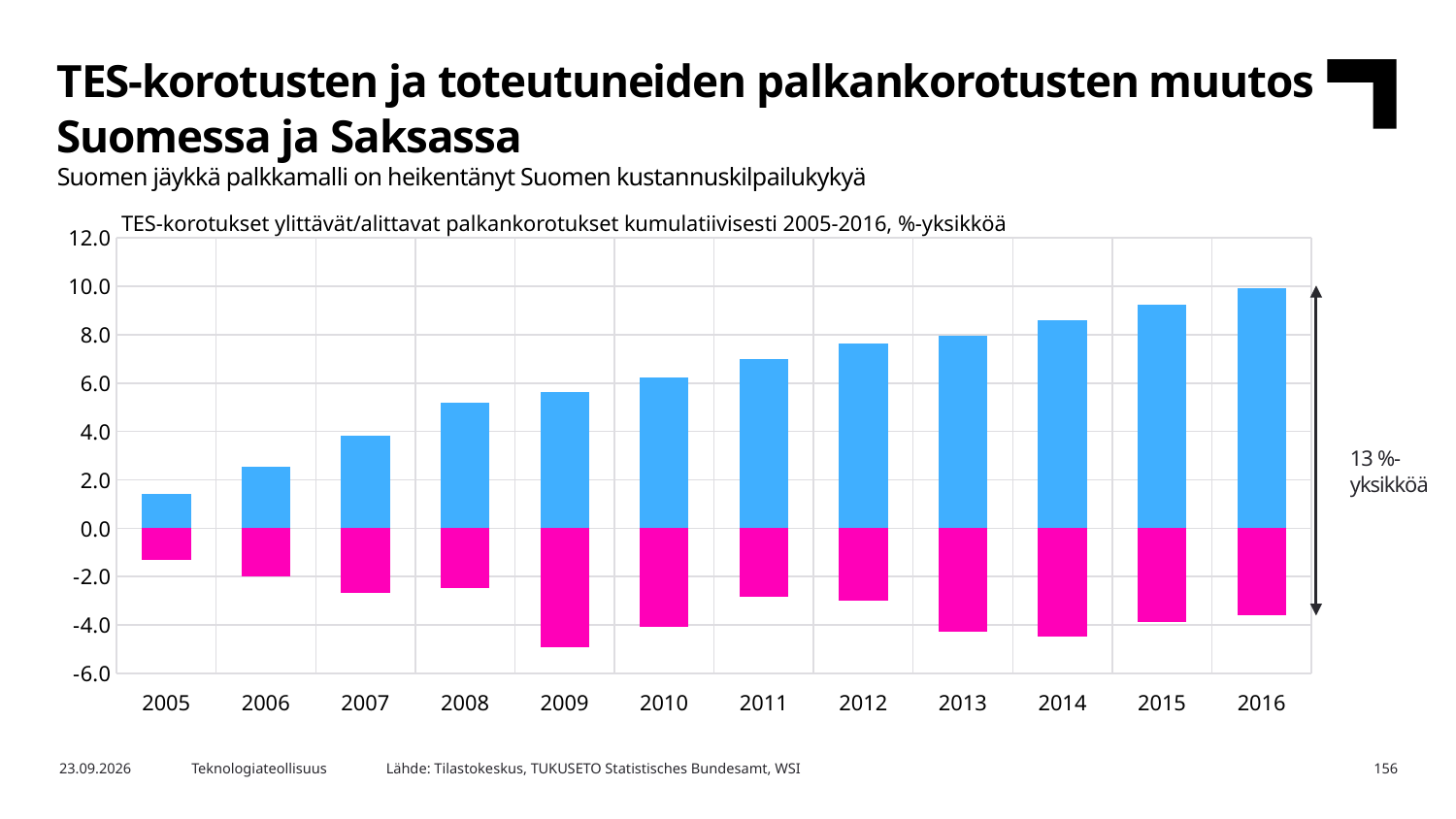
Do the blue (positive) bars rise or fall from 2005 to 2016? rise How many years are shown on the x axis of the chart? 12 Is the blue bar for 2005 greater or less than 2.0? less Which year has the larger blue bar, 2008 or 2012? 2012 What is the last year shown on the x axis? 2016 In which year does the magenta (negative) bar reach the lowest value? 2009 Is the magenta bar for 2009 greater or less than -4.0? less What kind of chart is shown on the slide? bar chart In which year is the blue (positive) bar the highest? 2016 What is the first year shown on the x axis? 2005 In which year is the blue (positive) bar the lowest? 2005 Is the blue bar for 2016 greater or less than 8.0? greater